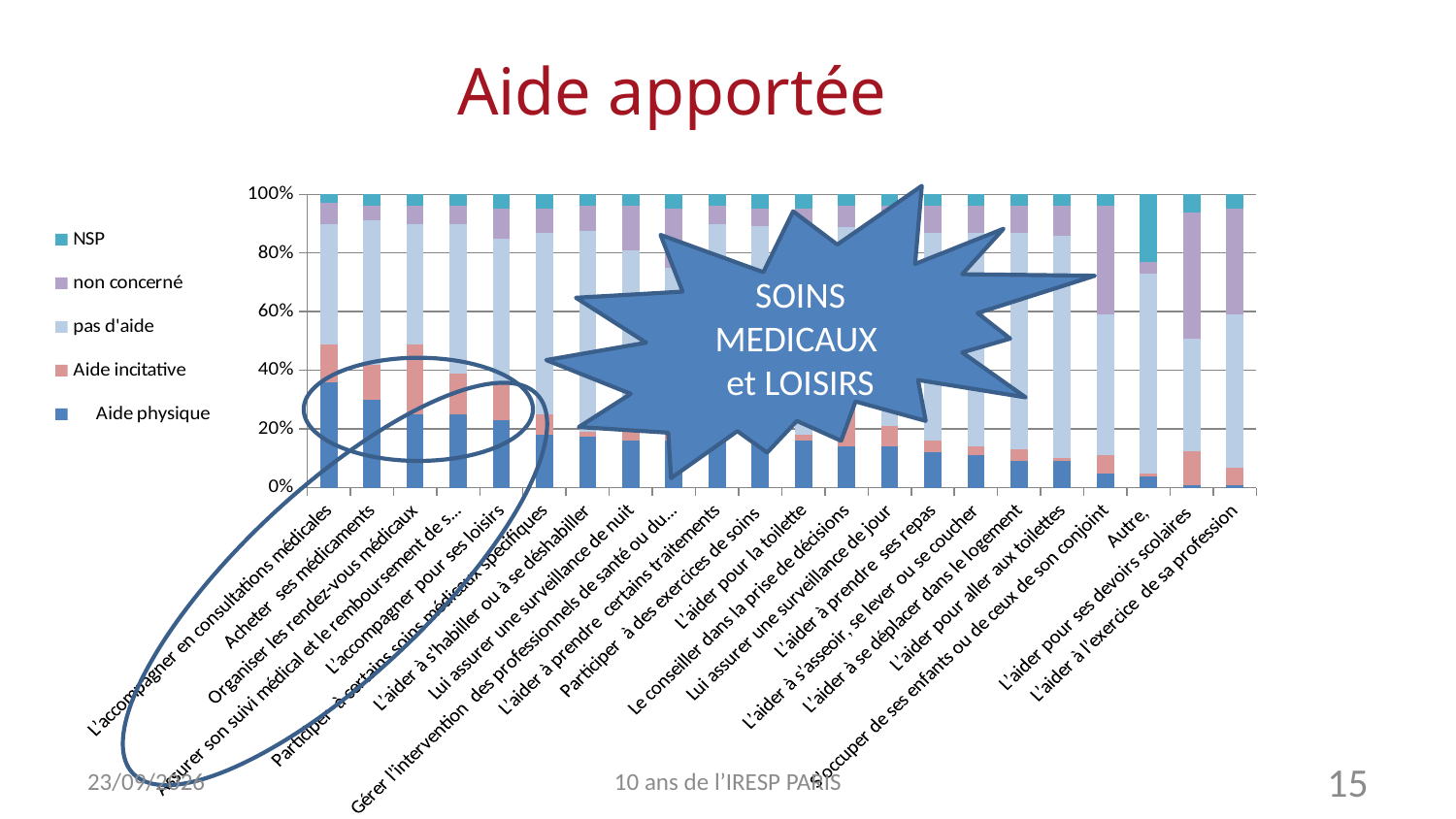
Which category has the highest 'Aide physique' value? L'accompagner en consultations médicales What kind of chart is shown on the slide? stacked bar chart Which series is listed first in the legend? NSP How many series does the legend list? 5 Is the 'non concerné' value for 'L'aider à l'exercice de sa profession' greater or less than 20%? greater Do the 'Aide physique' values generally rise or fall from left to right along the x axis? fall Which has the larger 'Aide physique' value: 'L'accompagner en consultations médicales' or 'L'aider pour ses devoirs scolaires'? L'accompagner en consultations médicales Is the 'Aide physique' value for 'L'accompagner en consultations médicales' greater or less than 20%? greater Is the 'Aide physique' value for 'Acheter ses médicaments' greater or less than 20%? greater What is the title of the slide containing the chart? Aide apportée How many categories are plotted along the x axis? 22